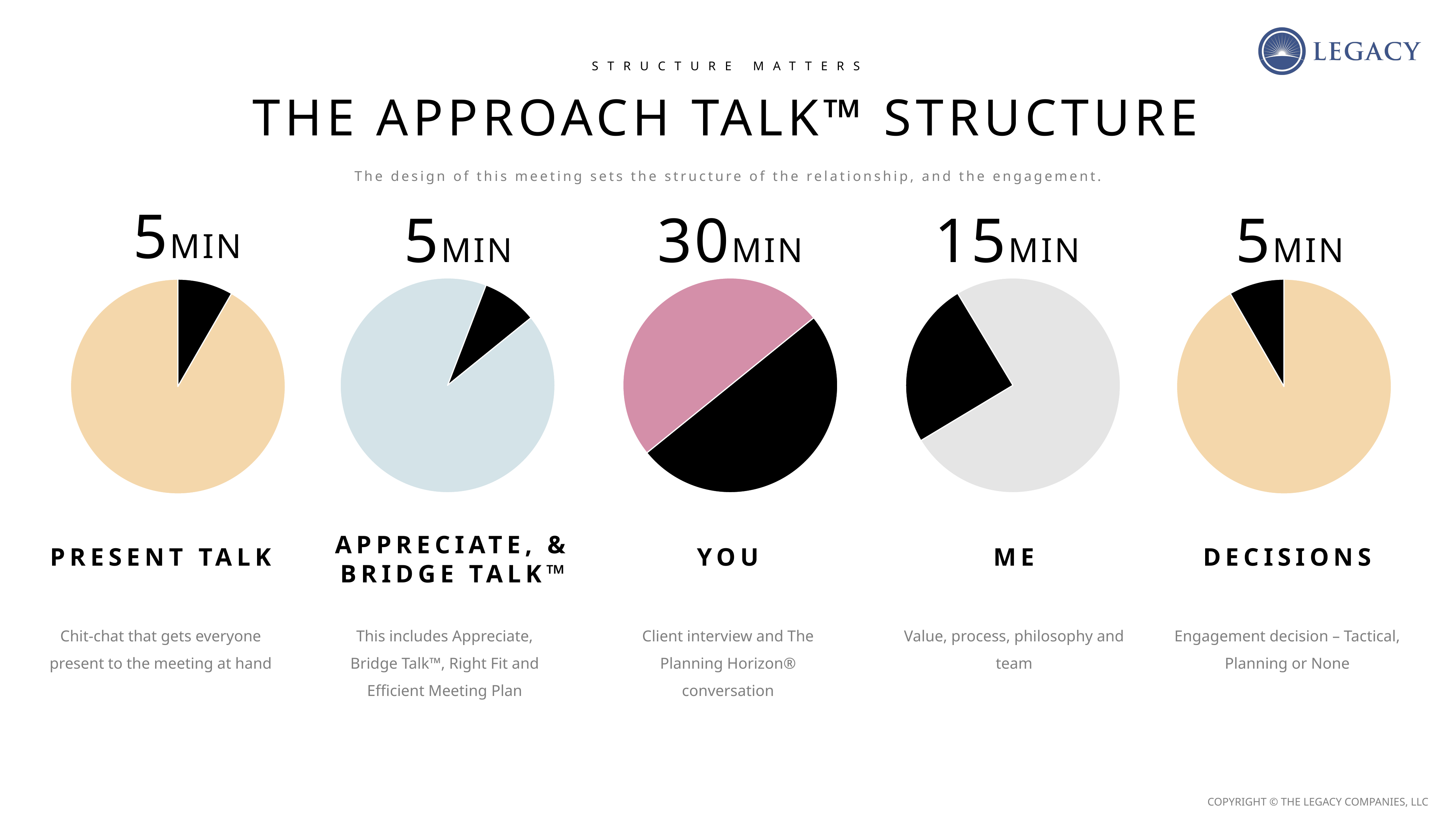
What is the total number of minutes across all five segments? 60 MIN How many minutes are allotted to the Appreciate, & Bridge Talk segment? 5 MIN How many minutes are allotted to the You segment? 30 MIN What kind of charts are used to show the time for each segment? Pie charts Which segment of the Approach Talk structure has the most minutes? You How many pie charts are shown on the slide? 5 How many minutes are allotted to the Decisions segment? 5 MIN Which has more minutes, the Me segment or the Decisions segment? Me How many minutes are allotted to the Me segment? 15 MIN How many more minutes does the You segment have than the Me segment? 15 MIN How many minutes are allotted to the Present Talk segment? 5 MIN What colour is the highlighted slice in the You pie chart? Black